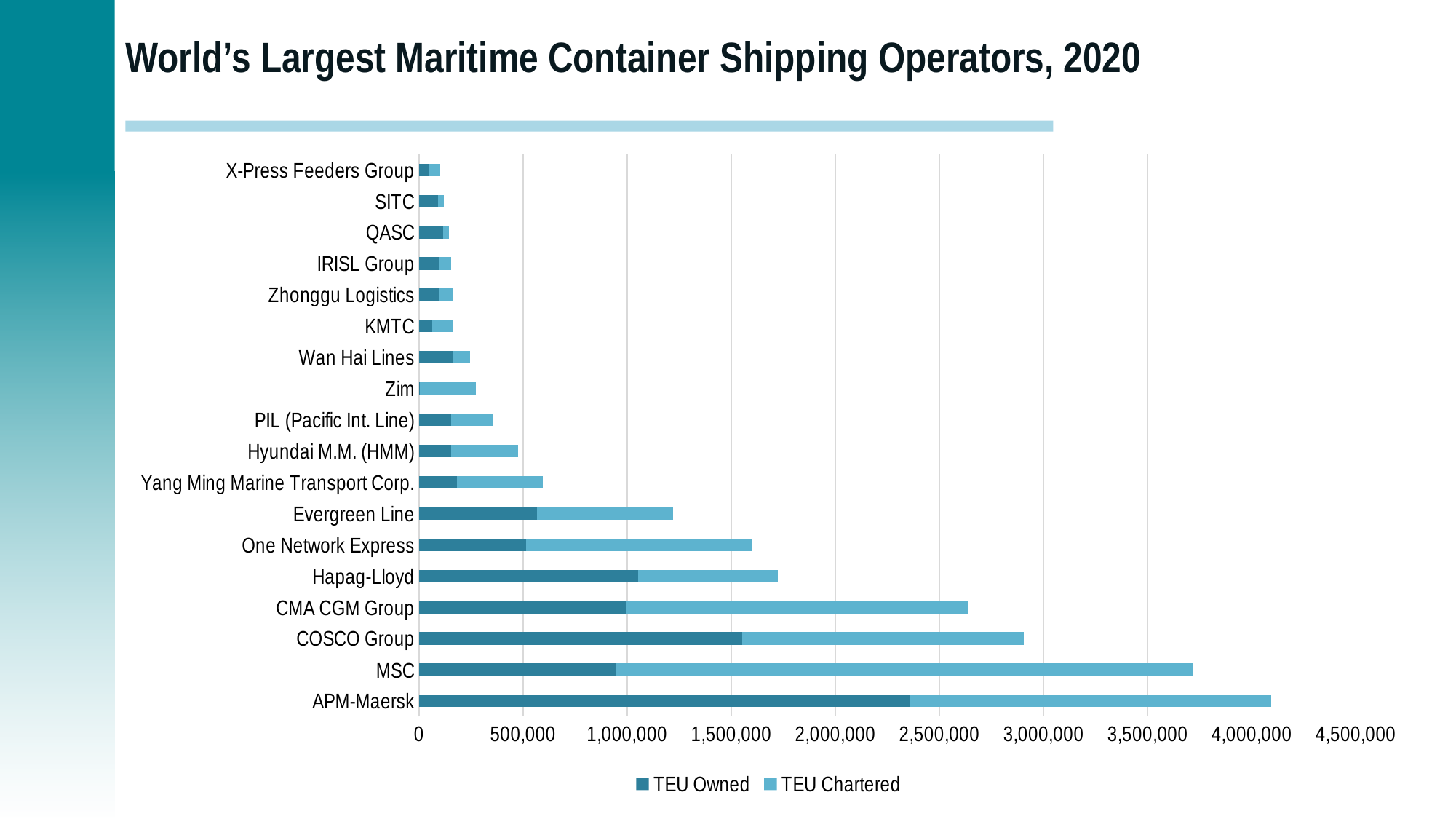
How many shipping operators are listed on the chart? 18 Is the TEU Owned segment for APM-Maersk greater or less than 2,000,000? greater What kind of chart is shown on the slide? Stacked bar chart Is the total bar for COSCO Group greater or less than 3,000,000? less Which operator has the longest total bar (owned plus chartered TEU)? APM-Maersk Which operator has the shortest total bar? X-Press Feeders Group Is the total bar for Evergreen Line greater or less than 1,000,000? greater What are the two series named in the legend? TEU Owned and TEU Chartered Which has the larger TEU Owned segment, APM-Maersk or MSC? APM-Maersk How many series does the legend list? 2 Which operator has the largest TEU Chartered segment? MSC